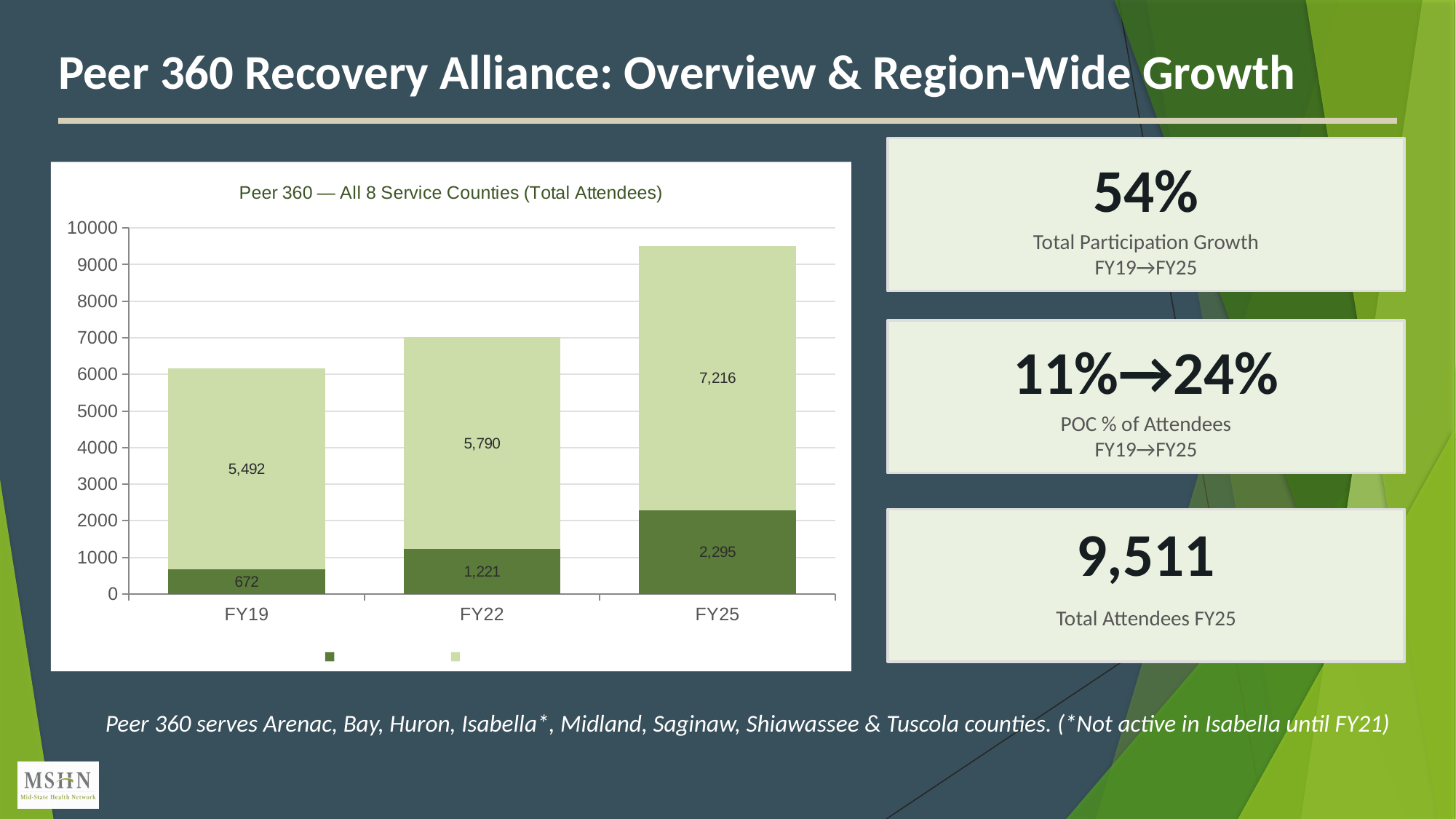
How many fiscal years are shown on the x axis? 3 What is the value of the dark green segment for FY22? 1,221 Which fiscal year has the tallest stacked bar? FY25 What is the value of the dark green segment for FY19? 672 Is the light green segment larger for FY22 or FY19? FY22 Which fiscal year has the smallest dark green segment? FY19 What is the difference between the light green segment values for FY25 and FY19? 1,724 What is the total of the stacked bar for FY19? 6,164 What is the value of the light green segment for FY25? 7,216 Do the total bar heights rise or fall from FY19 to FY25? Rise What kind of chart is shown on the slide? Stacked bar chart What is the total of the stacked bar for FY25? 9,511